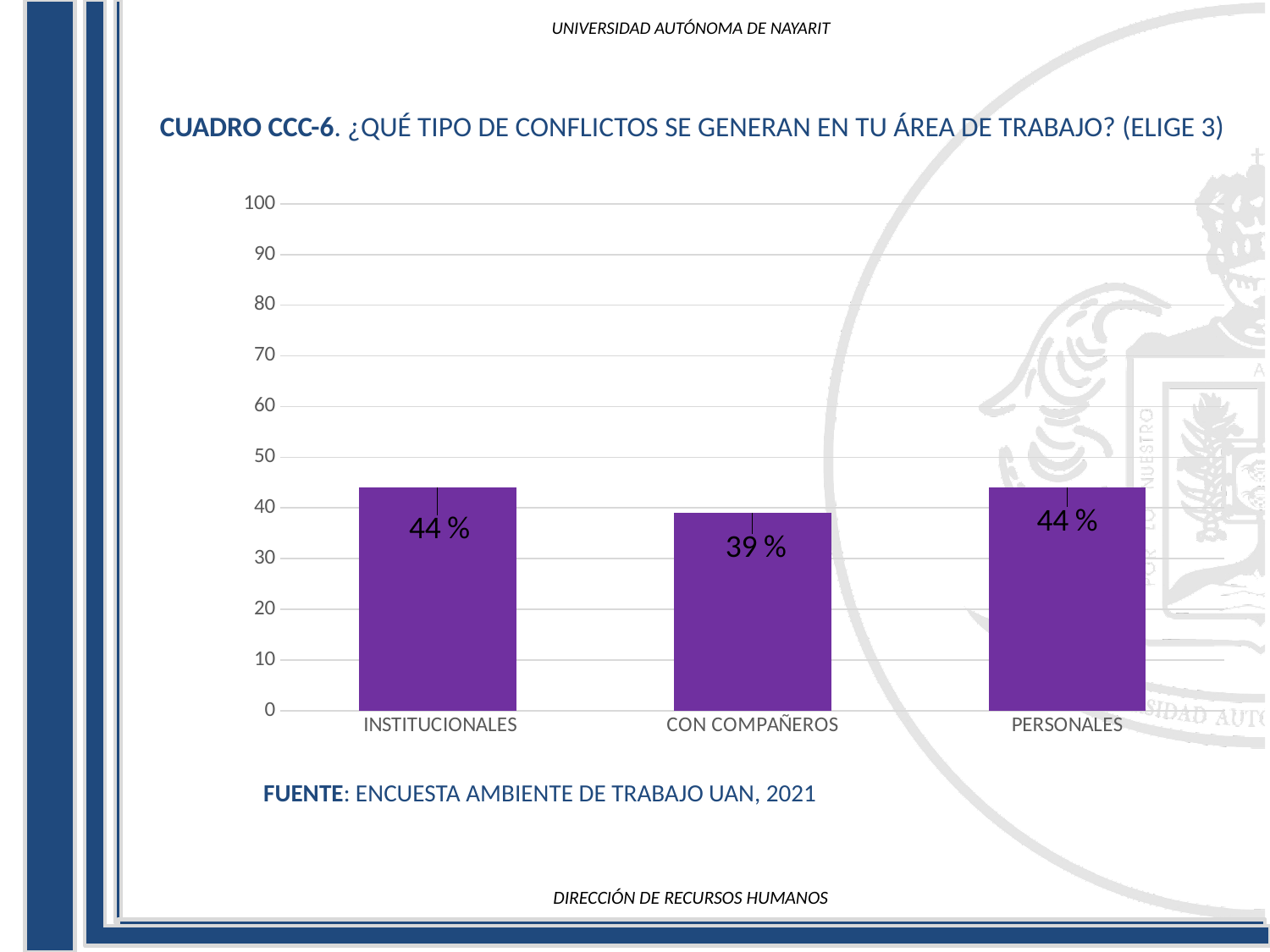
What is the maximum value shown on the vertical axis? 100 Which category has the lowest value? CON COMPAÑEROS What kind of chart is shown on the slide? bar chart Is the value for CON COMPAÑEROS greater or less than 50? less What is the difference between the values for INSTITUCIONALES and CON COMPAÑEROS? 5 % How many categories are shown on the x axis? 3 Is the value for INSTITUCIONALES greater or less than 40? greater What source is cited below the chart? ENCUESTA AMBIENTE DE TRABAJO UAN, 2021 What is the value for PERSONALES? 44 % What is the value for CON COMPAÑEROS? 39 % Which is larger, the value for PERSONALES or the value for CON COMPAÑEROS? PERSONALES What is the value for INSTITUCIONALES? 44 %